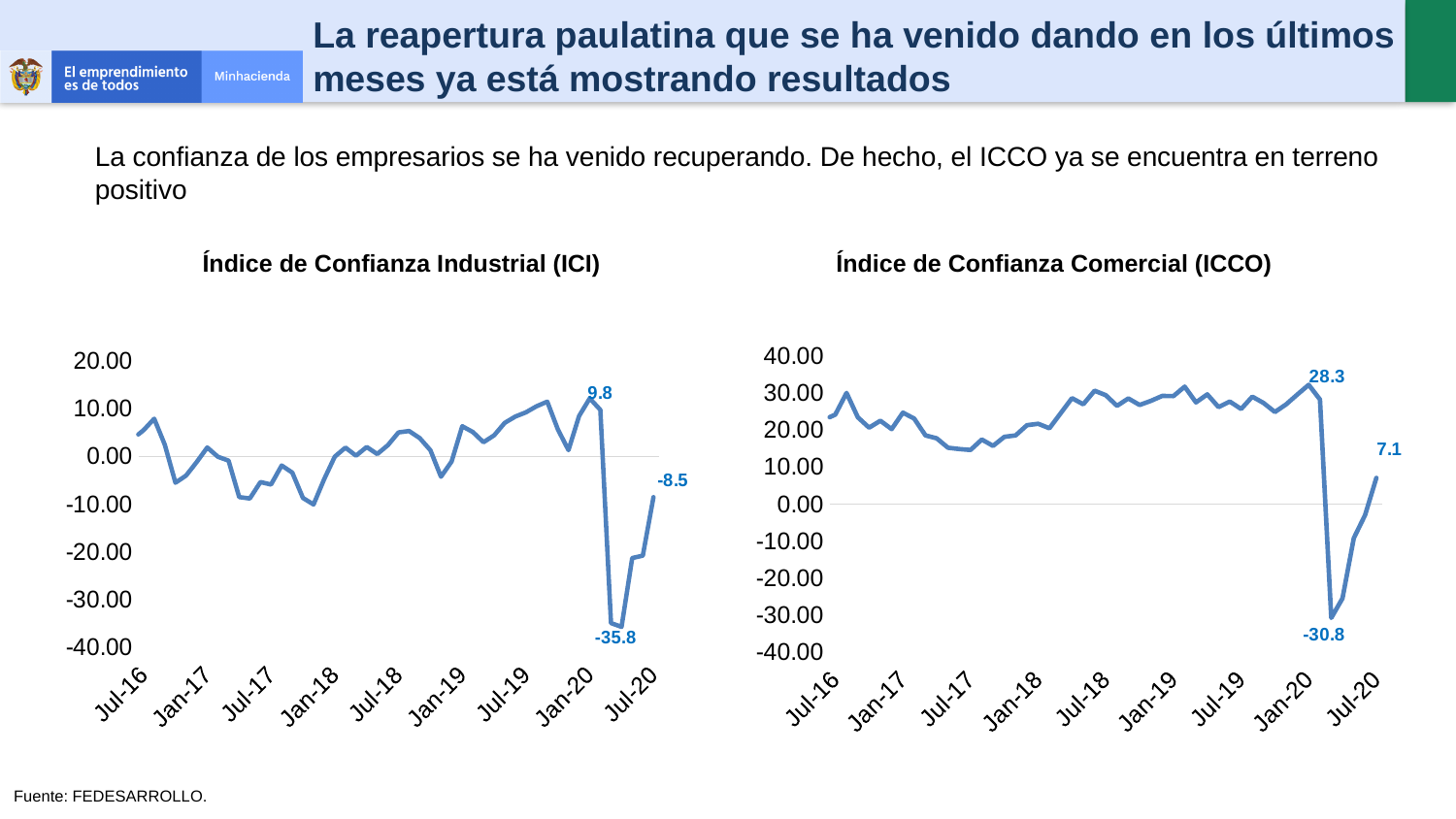
What type of chart is used for the Índice de Confianza Industrial (ICI)? Line chart In the Índice de Confianza Industrial (ICI) chart, what is the value of the last data point (Jul-20)? -8.5 In the Índice de Confianza Industrial (ICI) chart, what is the labelled peak value reached just before the sharp drop in 2020? 9.8 In the Índice de Confianza Industrial (ICI) chart, what is the lowest labelled value of the series? -35.8 In the Índice de Confianza Comercial (ICCO) chart, what is the labelled peak value reached just before the sharp drop in 2020? 28.3 In the Índice de Confianza Industrial (ICI) chart, what is the difference between the last value (-8.5) and the lowest labelled value (-35.8)? 27.3 In the Índice de Confianza Comercial (ICCO) chart, what is the lowest labelled value of the series? -30.8 Which chart ends with a higher final value in Jul-20, the ICI chart or the ICCO chart? ICCO In the Índice de Confianza Comercial (ICCO) chart, does the series rise or fall between its lowest point in 2020 and Jul-20? Rise In the Índice de Confianza Comercial (ICCO) chart, what is the value of the last data point (Jul-20)? 7.1 In the Índice de Confianza Comercial (ICCO) chart, is the value at Jan-19 greater or less than 20? greater In the Índice de Confianza Comercial (ICCO) chart, what is the difference between the labelled peak (28.3) and the last value (7.1)? 21.2